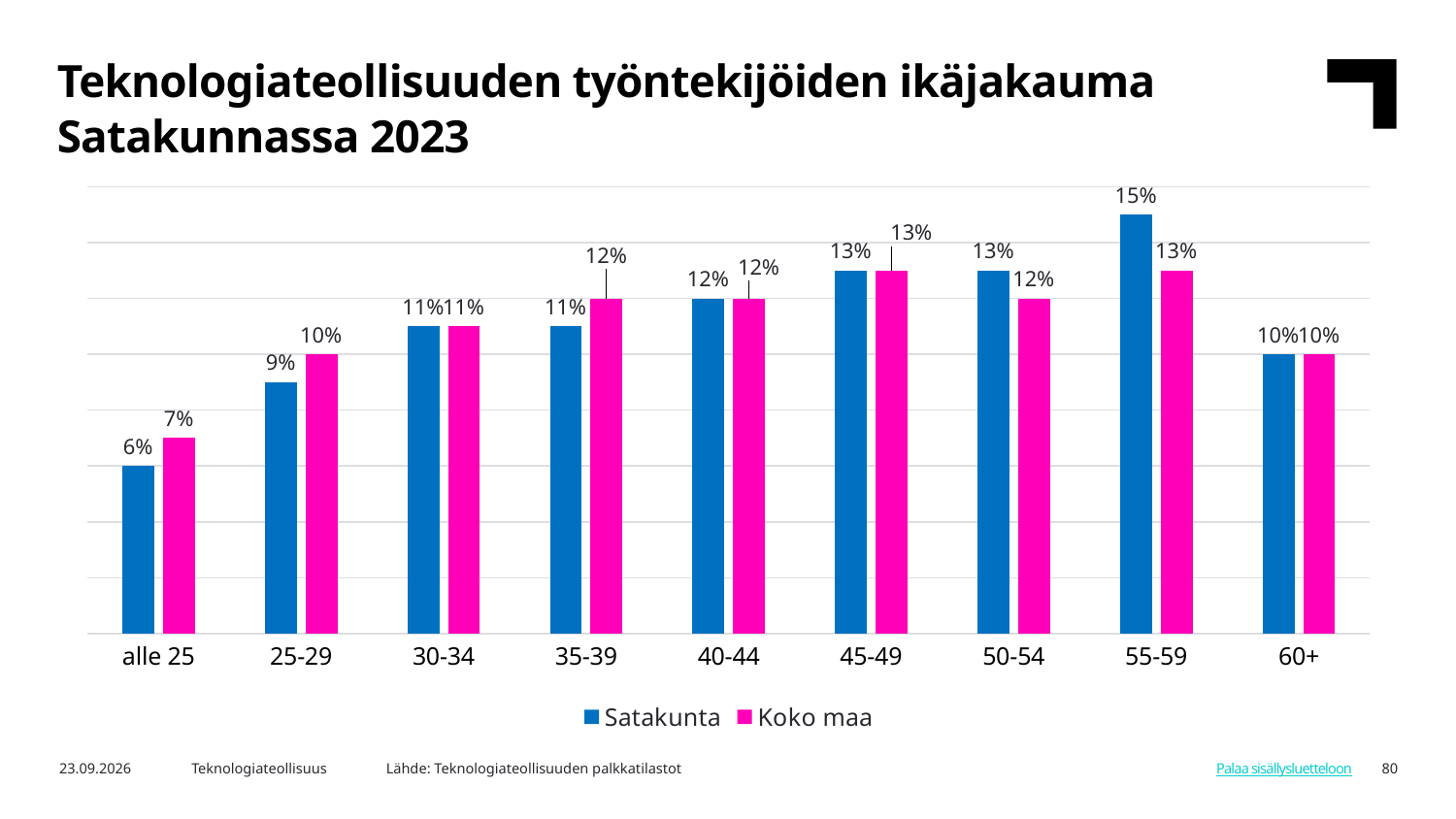
What is the difference between the Satakunta and Koko maa values in the 55-59 age group? 2% What kind of chart is shown on the slide? bar chart What is the value for Satakunta in the 55-59 age group? 15% What is the value for Koko maa in the 25-29 age group? 10% How many series does the legend list? 2 Which age group has the lowest value for Koko maa? alle 25 Which age group has the highest value for Satakunta? 55-59 What is the title of the chart on the slide? Teknologiateollisuuden työntekijöiden ikäjakauma Satakunnassa 2023 In the 25-29 age group, which series has the larger value, Satakunta or Koko maa? Koko maa How many age categories are shown on the x axis? 9 What is the value for Satakunta in the alle 25 age group? 6% Do the Satakunta values rise or fall from the alle 25 group to the 55-59 group? rise